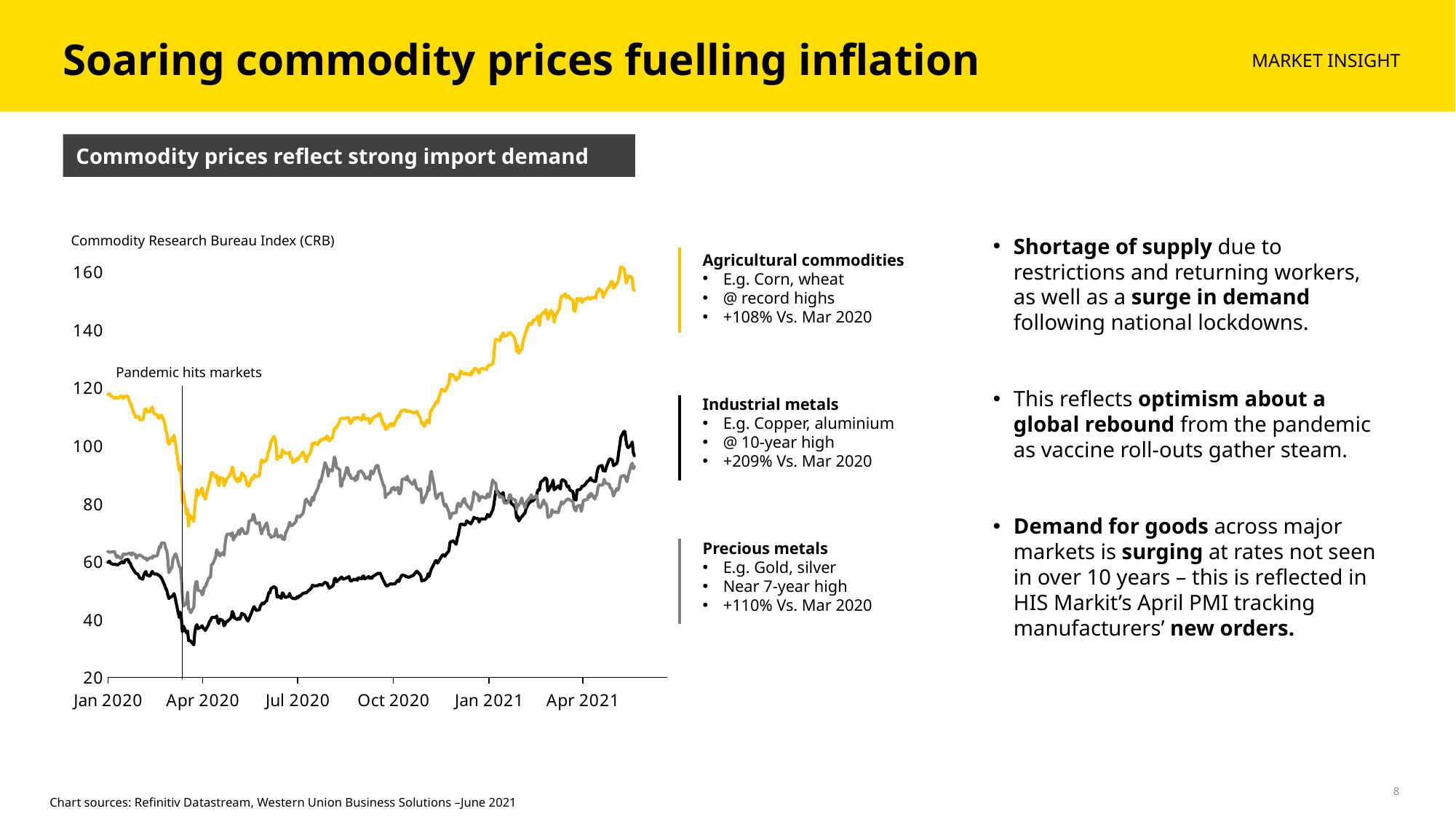
How many series does the chart's legend list? 3 Is the lowest value for Industrial metals around Apr 2020 greater or less than 40? less Which series has the highest value at the end of the chart in Apr 2021? Agricultural commodities In Jan 2020, which is larger: Agricultural commodities or Industrial metals? Agricultural commodities According to the legend, by what percentage have Industrial metals changed vs. Mar 2020? +209% Does the Industrial metals series rise or fall between Apr 2020 and Apr 2021? rise Is the peak value for Agricultural commodities in Apr 2021 greater or less than 140? greater What event does the vertical line on the chart mark? Pandemic hits markets What kind of chart is shown on the slide? line chart Is the value for Industrial metals in Jan 2020 greater or less than 80? less Which series has the lowest value around Apr 2020? Industrial metals